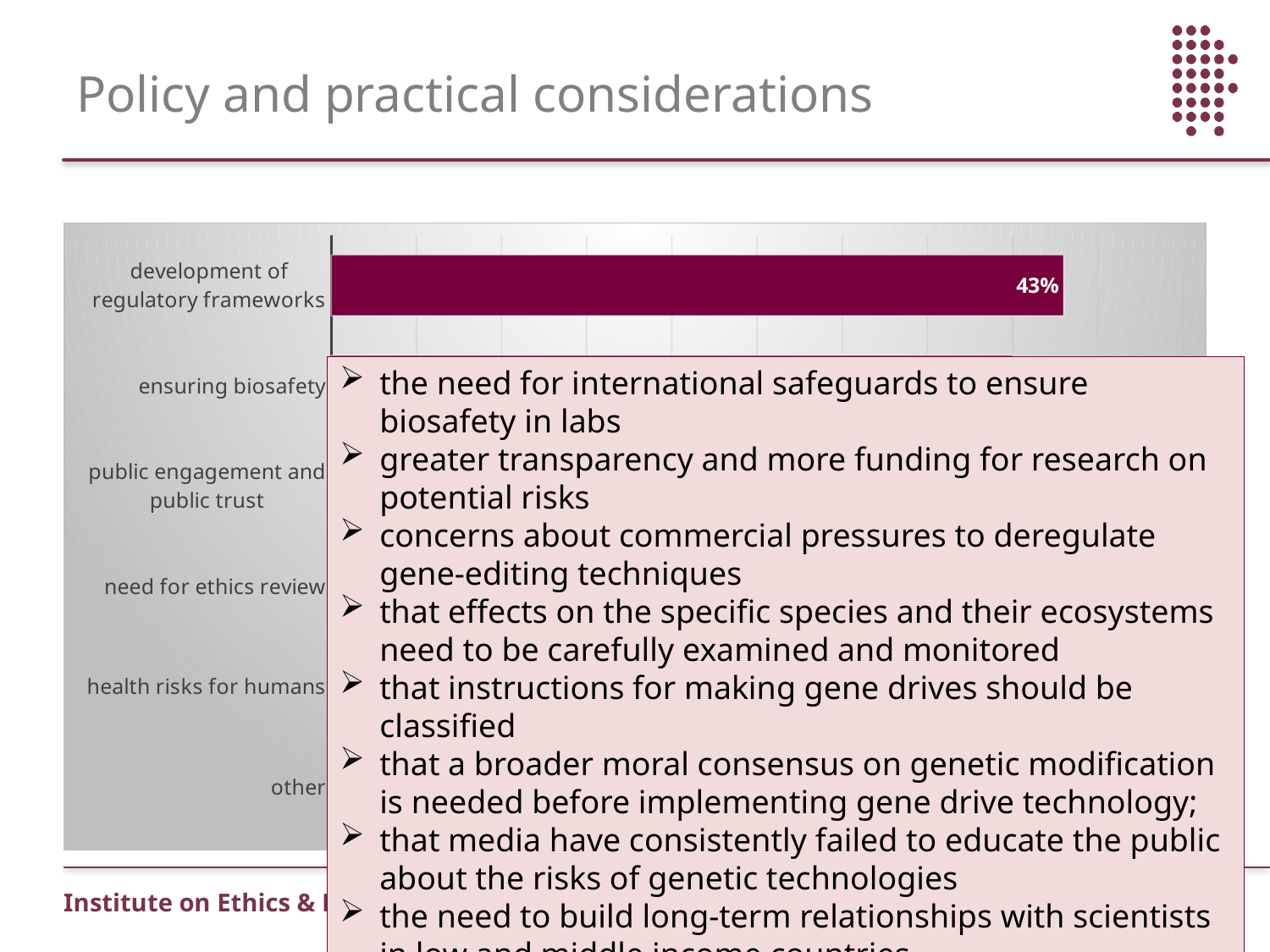
Which category is listed at the top of the chart? development of regulatory frameworks How many categories are listed on the chart's vertical axis? 6 What kind of chart is shown on the slide? bar chart What is the value shown for development of regulatory frameworks? 43% Which category is listed at the bottom of the chart? other